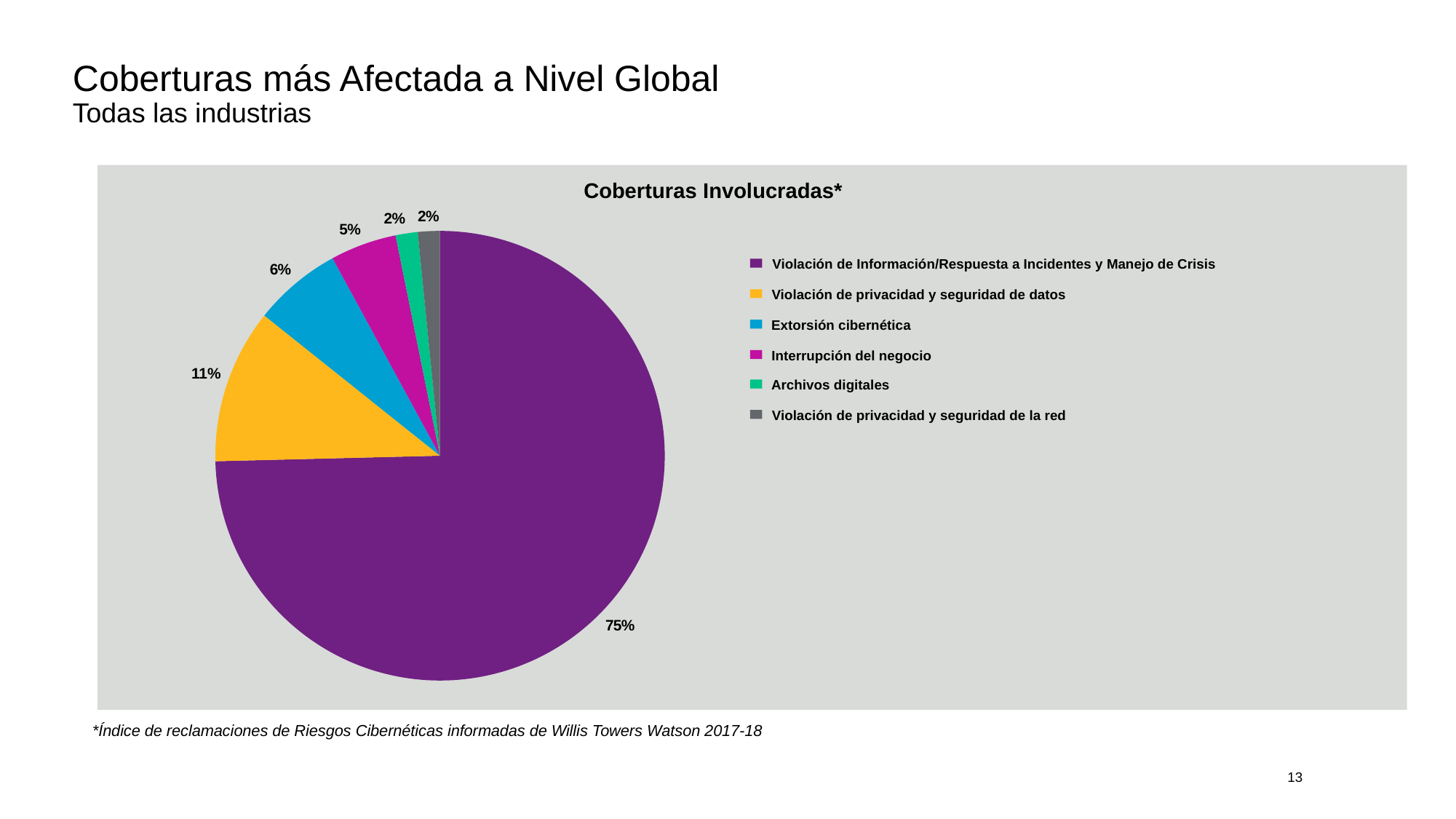
What is the title of the chart? Coberturas Involucradas* What is the value for Extorsión cibernética? 6% What colour is the slice for Violación de privacidad y seguridad de datos? Yellow What is the value for Interrupción del negocio? 5% What is the difference between the values for Violación de privacidad y seguridad de datos and Extorsión cibernética? 5% What share of the pie does Violación de Información/Respuesta a Incidentes y Manejo de Crisis represent? 75% Which is larger, the value for Extorsión cibernética or the value for Interrupción del negocio? Extorsión cibernética What is the value for Violación de privacidad y seguridad de datos? 11% What kind of chart is shown on the slide? Pie chart How many categories does the legend list? 6 What is the value for Archivos digitales? 2% Which category has the largest slice of the pie? Violación de Información/Respuesta a Incidentes y Manejo de Crisis